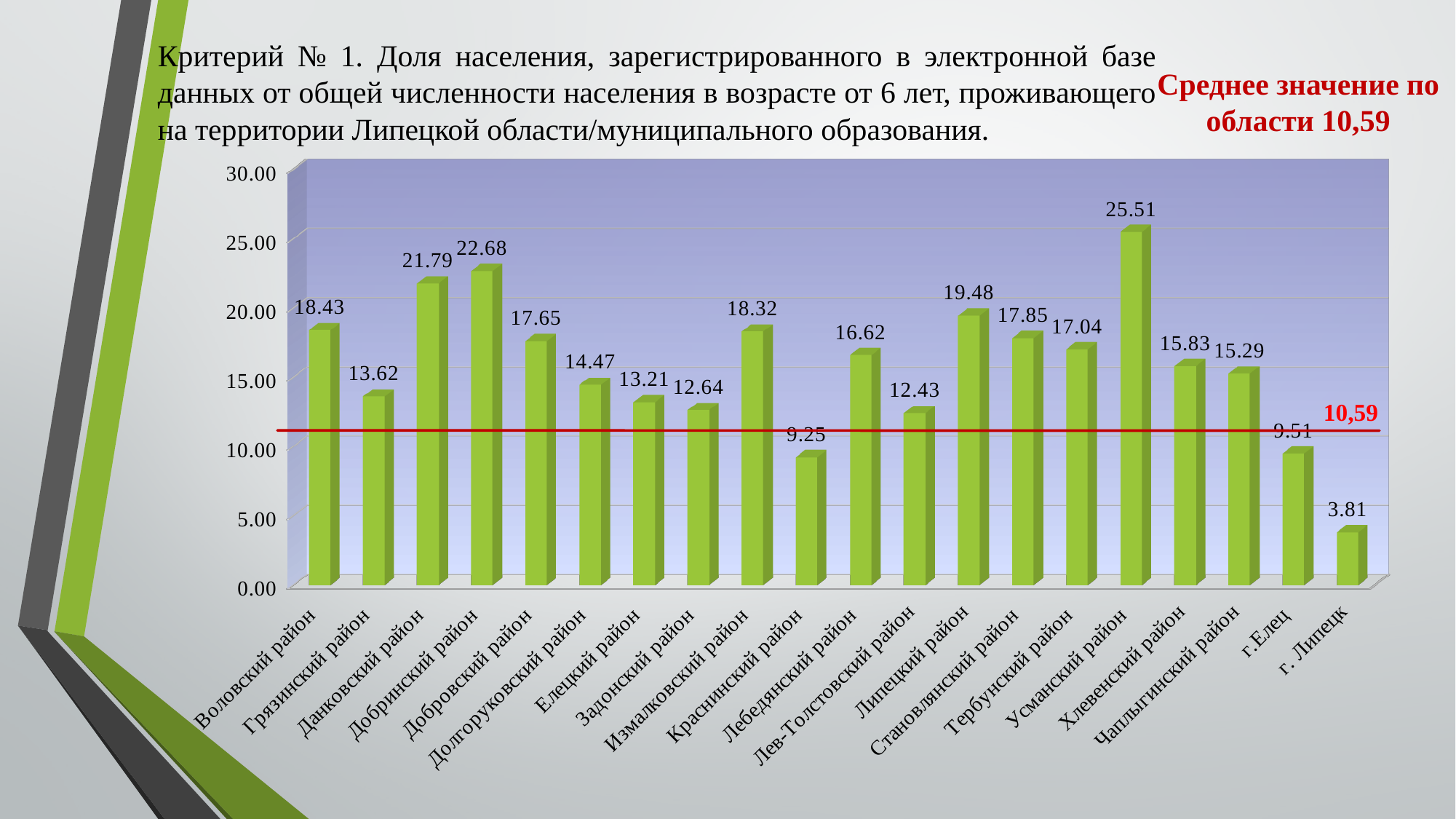
How many categories are shown on the x axis? 20 What is the value for Краснинский район? 9.25 What value does the red horizontal line on the chart represent? 10,59 What is the value for г. Липецк? 3.81 Which category has the highest value? Усманский район Which is larger, the value for Липецкий район or the value for Становлянский район? Липецкий район What kind of chart is shown on the slide? bar chart What is the difference between the values for Добринский район and Данковский район? 0.89 What is the difference between the values for Усманский район and г.Елец? 16.00 Which category has the lowest value? г. Липецк Is the value for Лебедянский район greater or less than 15.00? greater What is the value for Воловский район? 18.43